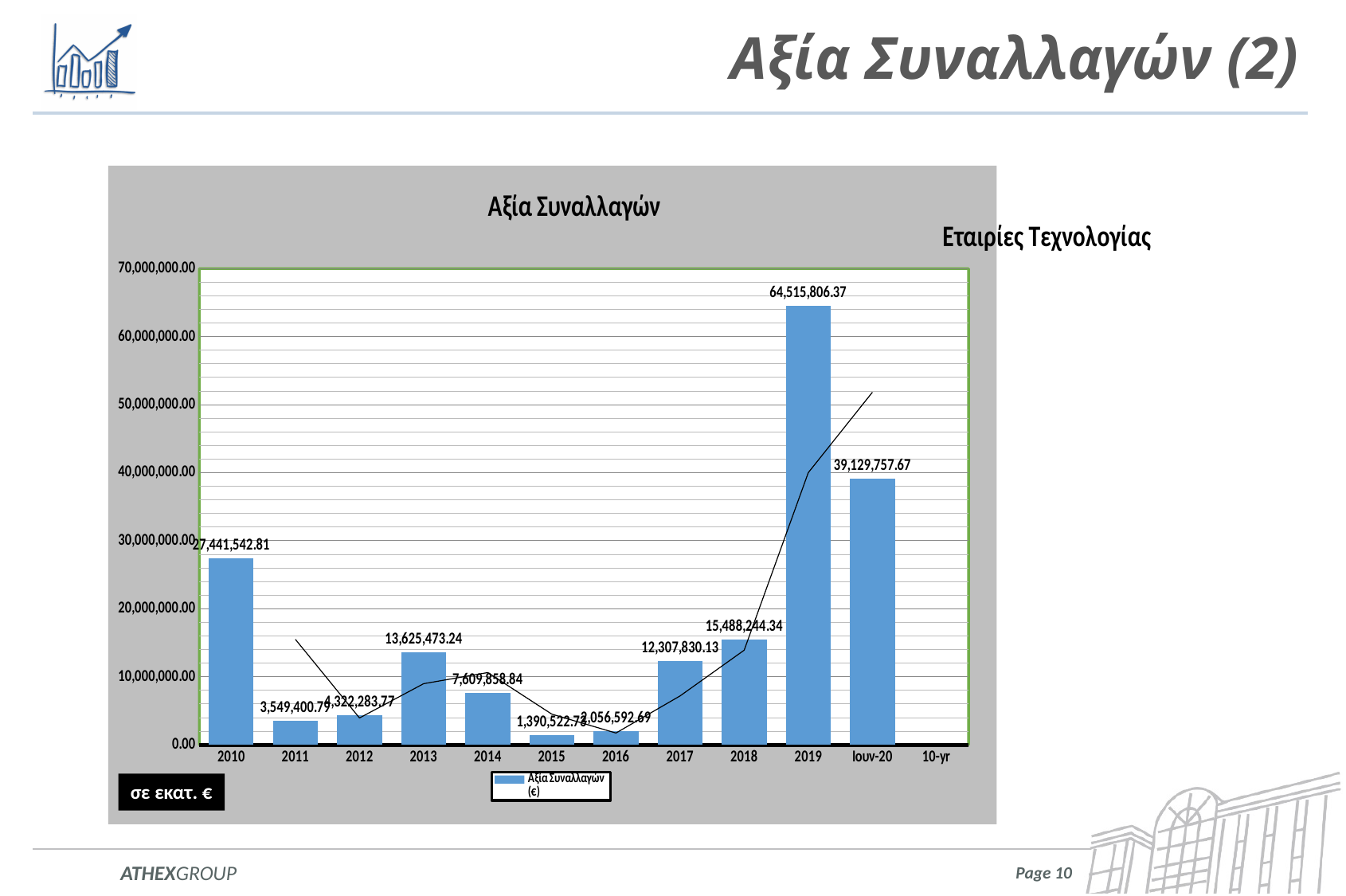
What kind of chart is the Αξία Συναλλαγών chart? bar chart What is the difference between the values for 2018 and 2017 in the Αξία Συναλλαγών chart? 3,180,414.21 What is the value for 2019 in the Αξία Συναλλαγών chart? 64,515,806.37 What is the value for 2010 in the Αξία Συναλλαγών chart? 27,441,542.81 Which is larger in the Αξία Συναλλαγών chart, the value for 2013 or the value for 2014? 2013 Which year has the highest value in the Αξία Συναλλαγών chart? 2019 What is the value for Ιουν-20 in the Αξία Συναλλαγών chart? 39,129,757.67 Do the values in the Αξία Συναλλαγών chart rise or fall from 2016 to 2019? rise How many series does the legend of the Αξία Συναλλαγών chart list? 1 What is the difference between the values for 2019 and Ιουν-20 in the Αξία Συναλλαγών chart? 25,386,048.70 Is the value for 2014 in the Αξία Συναλλαγών chart greater or less than 10,000,000.00? less What is the value for 2017 in the Αξία Συναλλαγών chart? 12,307,830.13